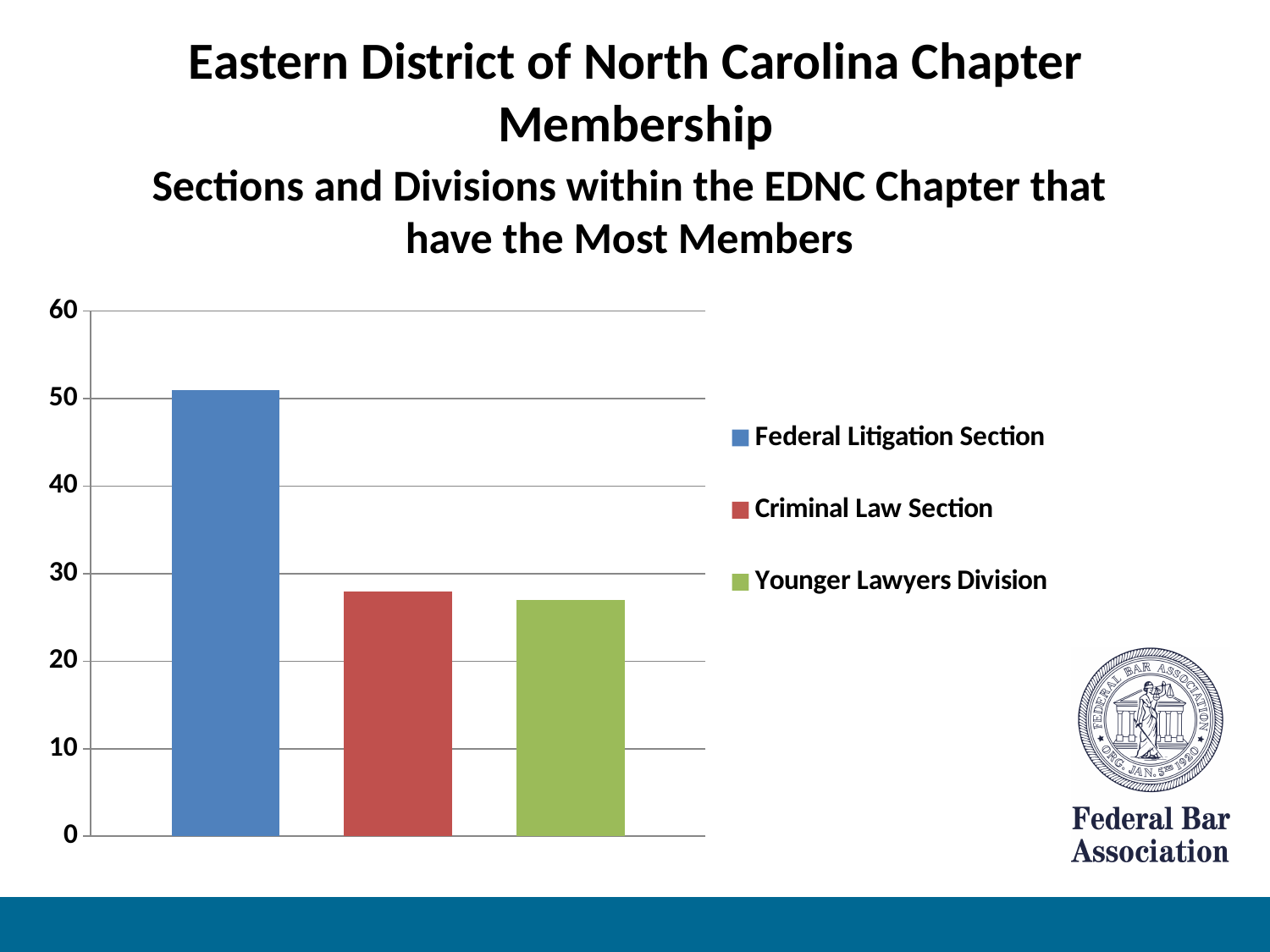
Is the value for the Criminal Law Section greater or less than 30? less Which section or division has the highest number of members in the chart? Federal Litigation Section What kind of chart is shown on the slide? bar chart What is the highest value shown on the chart's vertical axis? 60 Is the value for the Younger Lawyers Division greater or less than 20? greater How many bars are plotted in the chart? 3 Which has more members, the Federal Litigation Section or the Younger Lawyers Division? Federal Litigation Section Is the value for the Federal Litigation Section greater or less than 40? greater What colour is the bar for the Younger Lawyers Division? green Which has more members, the Federal Litigation Section or the Criminal Law Section? Federal Litigation Section How many entries does the chart's legend list? 3